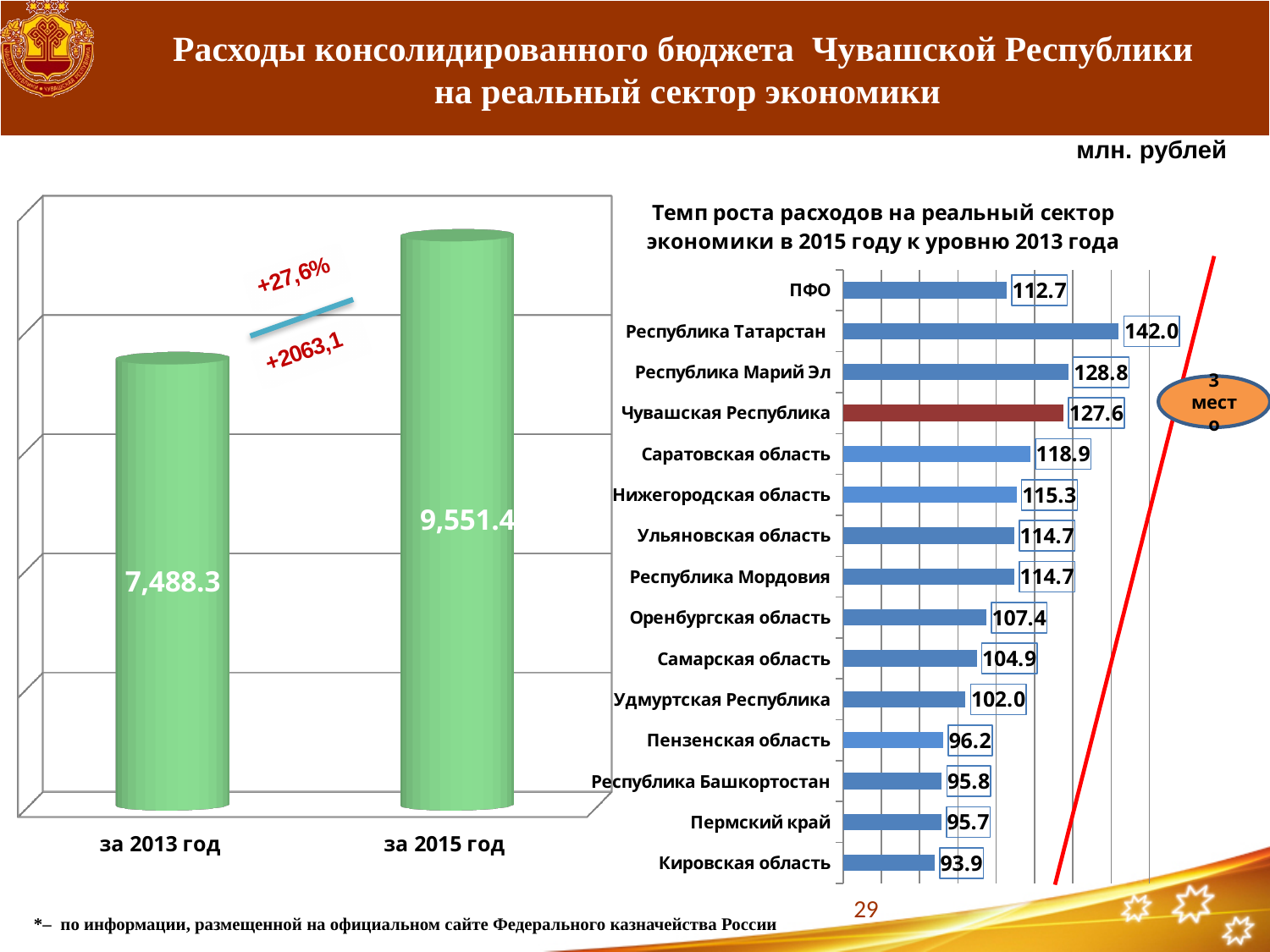
On the right chart (Темп роста расходов на реальный сектор экономики), which region has the highest value? Республика Татарстан On the left chart, what is the value for за 2013 год? 7,488.3 On the right chart, how many categories are plotted? 15 On the left chart, how many bars are plotted? 2 On the left chart, do the values rise or fall from 2013 to 2015? rise On the right chart, what is the value for ПФО? 112.7 On the left chart, what is the difference between the 2015 and 2013 values? 2,063.1 On the right chart (Темп роста расходов на реальный сектор экономики), which region has the lowest value? Кировская область On the right chart, what is the value for Чувашская Республика? 127.6 On the left chart, what is the value for за 2015 год? 9,551.4 On the right chart, which is larger: Республика Марий Эл or Саратовская область? Республика Марий Эл On the right chart, what is the difference between Республика Татарстан and Чувашская Республика? 14.4